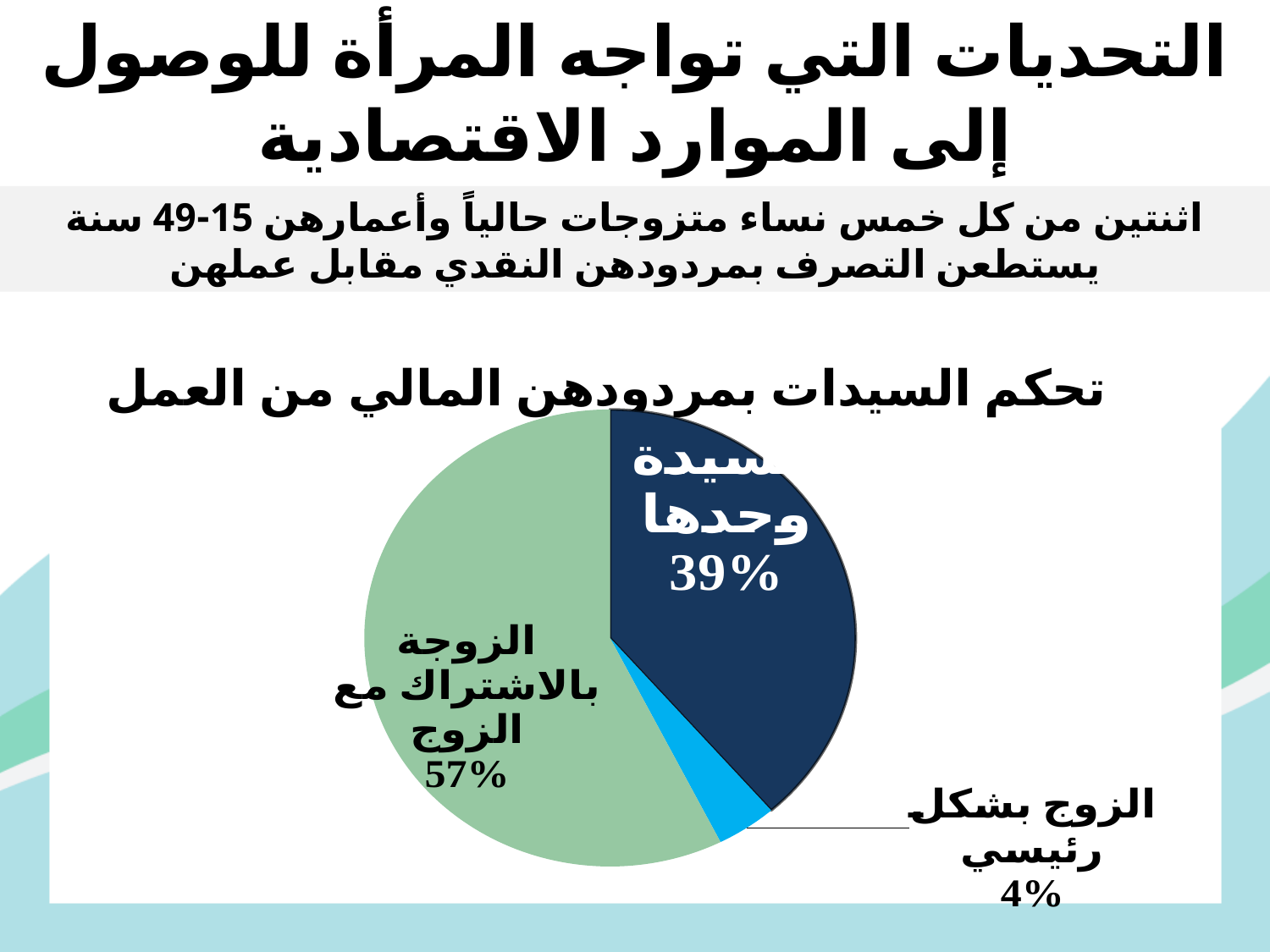
What is the title of the chart? تحكم السيدات بمردودهن المالي من العمل Which slice of the pie chart is the smallest? الزوج بشكل رئيسي What percentage is shown for the slice labelled "الزوجة بالاشتراك مع الزوج"? 57% Which is larger: the "سيدة وحدها" slice or the "الزوج بشكل رئيسي" slice? سيدة وحدها What percentage is shown for the slice labelled "سيدة وحدها"? 39% What percentage is shown for the slice labelled "الزوج بشكل رئيسي"? 4% What share of the pie does the "الزوج بشكل رئيسي" slice represent? 4% What kind of chart is shown on the slide? pie chart What is the difference in percentage points between the "الزوجة بالاشتراك مع الزوج" slice and the "سيدة وحدها" slice? 18 Which slice of the pie chart is the largest? الزوجة بالاشتراك مع الزوج How many slices does the pie chart have? 3 What colour is the slice labelled "الزوج بشكل رئيسي"? light blue